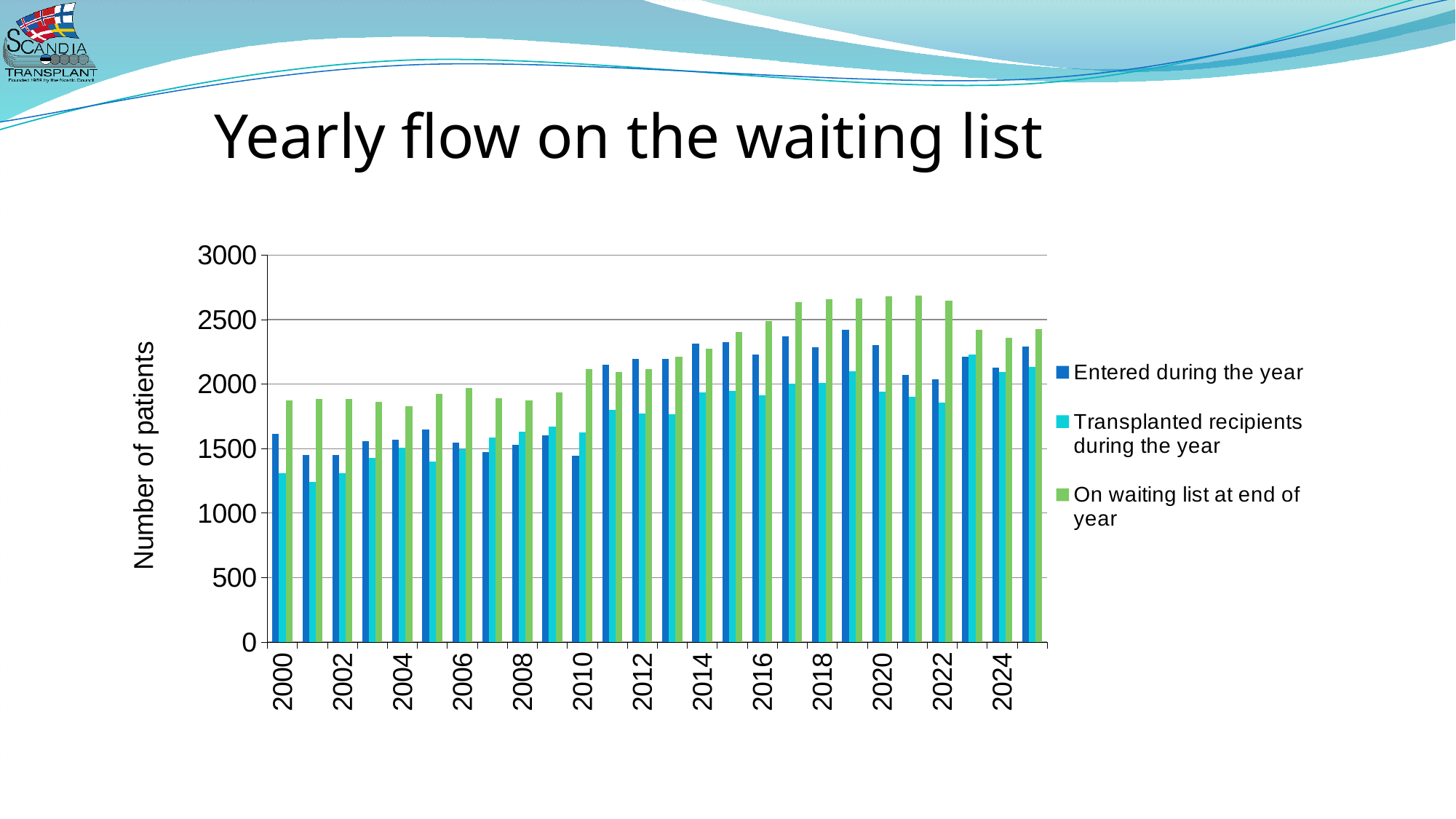
In 2010, which is larger: 'On waiting list at end of year' or 'Entered during the year'? On waiting list at end of year Which series is shown in green? On waiting list at end of year Does the 'On waiting list at end of year' series rise or fall from 2010 to 2021? rise Is the value for 'Transplanted recipients during the year' in 2023 greater or less than 2000? greater What type of chart is shown on the slide? bar chart What is the y-axis title of the chart? Number of patients Is the value for 'On waiting list at end of year' in 2000 greater or less than 2000? less Is the value for 'On waiting list at end of year' in 2021 greater or less than 2500? greater In which year is 'Transplanted recipients during the year' lowest? 2001 In 2000, which is larger: 'Entered during the year' or 'Transplanted recipients during the year'? Entered during the year How many series does the legend list? 3